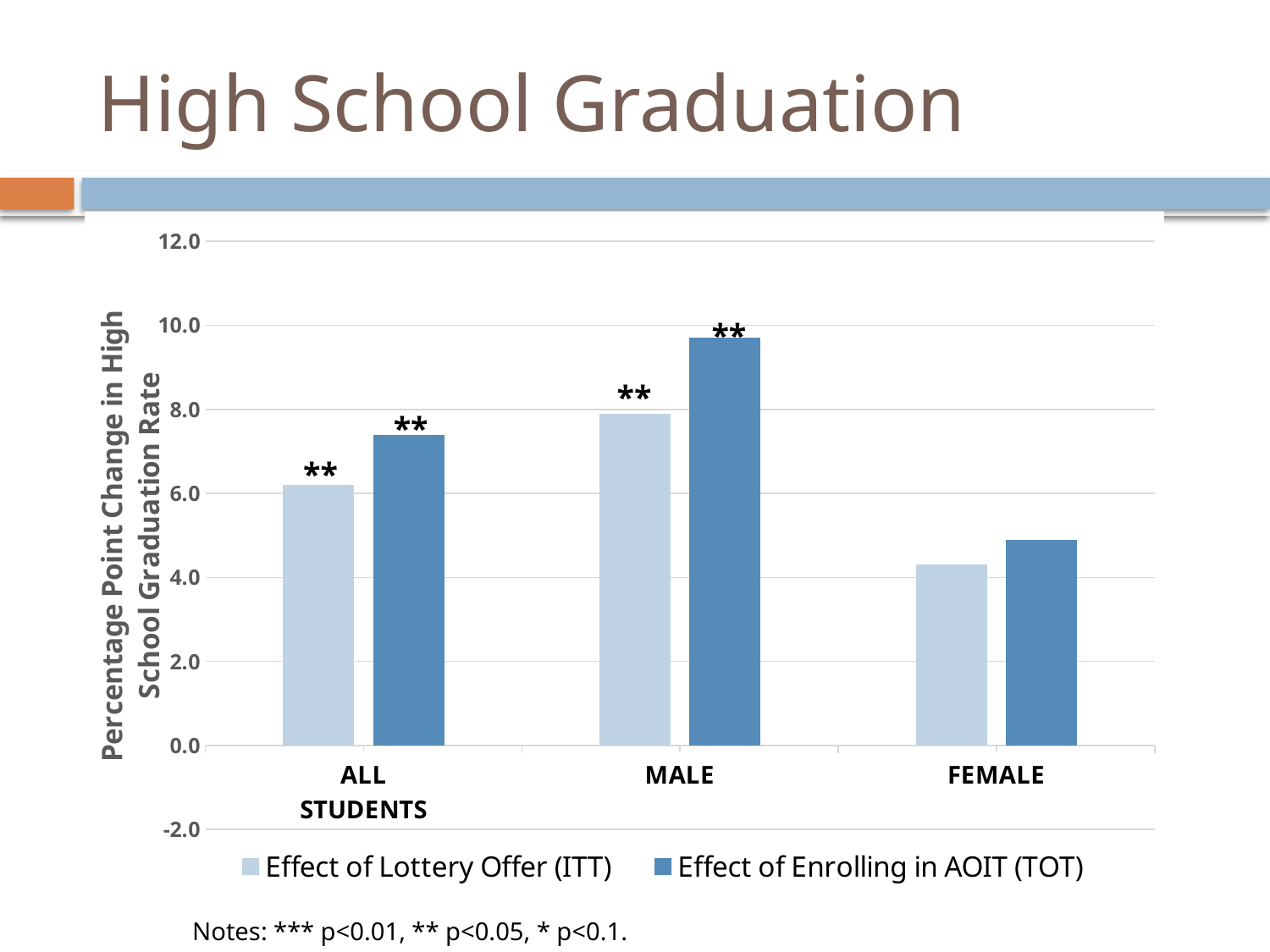
Which is larger: the Effect of Lottery Offer (ITT) for MALE or for FEMALE? MALE How many categories are shown on the x axis? 3 What is the y-axis title of the chart? Percentage Point Change in High School Graduation Rate What kind of chart is shown on the slide? bar chart Which category has the highest value for Effect of Enrolling in AOIT (TOT)? MALE Which category has the lowest value for Effect of Lottery Offer (ITT)? FEMALE Is the value for Effect of Enrolling in AOIT (TOT) for MALE greater or less than 8.0? greater Which category has no significance asterisks above its bars? FEMALE How many series does the legend list? 2 Is the value for Effect of Lottery Offer (ITT) for FEMALE greater or less than 6.0? less Is the value for Effect of Enrolling in AOIT (TOT) for ALL STUDENTS greater or less than 6.0? greater For MALE, which is larger: Effect of Lottery Offer (ITT) or Effect of Enrolling in AOIT (TOT)? Effect of Enrolling in AOIT (TOT)